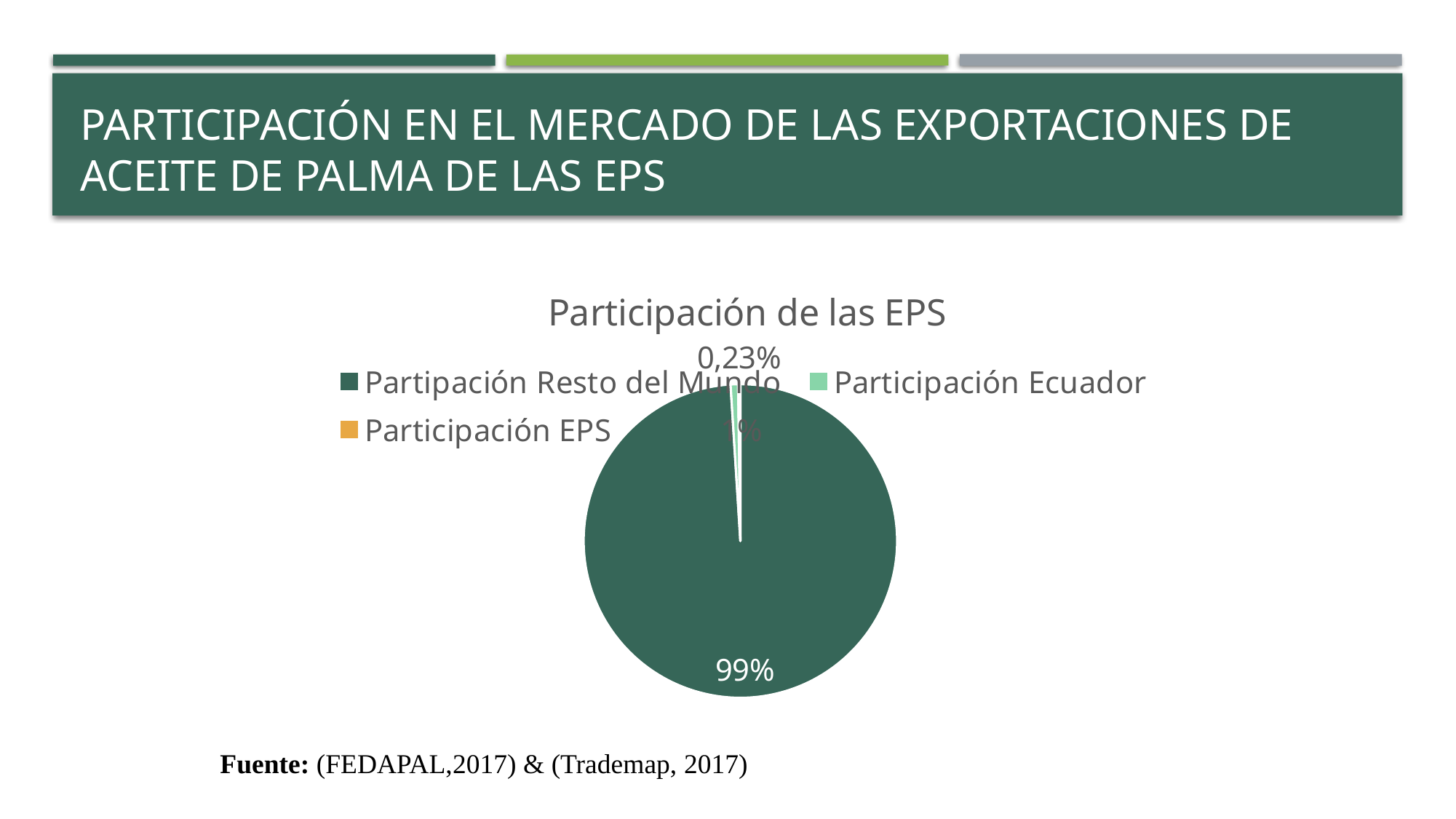
How many slices are labelled with a value on the pie chart? 3 What kind of chart is shown on the slide? pie chart What share of the pie does Participación Ecuador hold? 1% What value is shown for Participación EPS? 0,23% How many entries does the chart legend list? 3 Which legend entry is shown in orange? Participación EPS What is the difference between the share for Partipación Resto del Mundo and the share for Participación Ecuador? 98% Which is larger, the slice for Participación Ecuador or the slice for Partipación Resto del Mundo? Partipación Resto del Mundo Which category has the smallest slice of the pie? Participación EPS Which category has the largest slice of the pie? Partipación Resto del Mundo What is the title of the chart? Participación de las EPS What share of the pie does Partipación Resto del Mundo hold? 99%